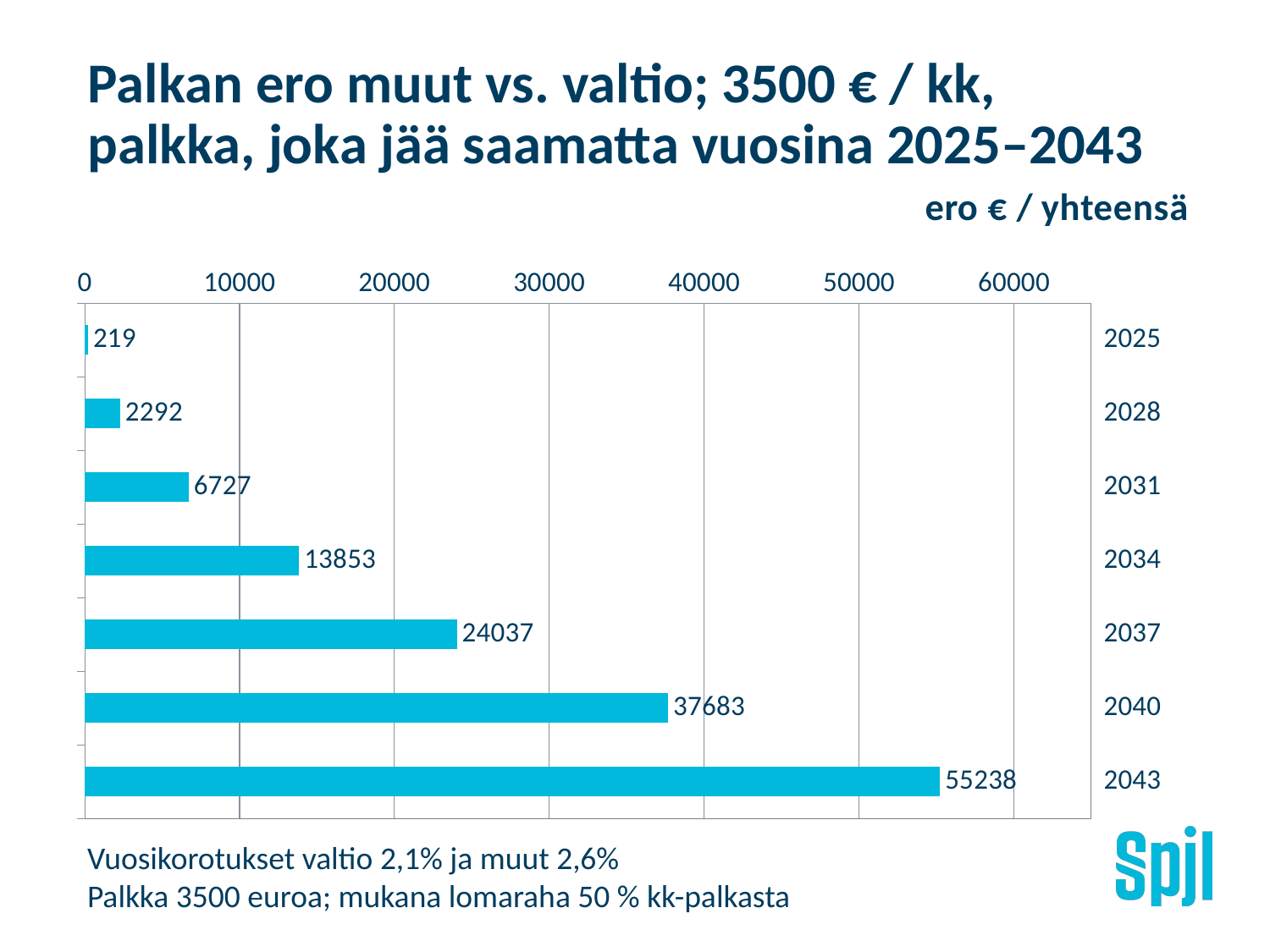
Do the values rise or fall from 2025 to 2043? rise Is the value for 2040 greater or less than 30000? greater Which year has the lowest value? 2025 Which is larger, the value for 2031 or the value for 2028? 2031 Which year has the highest value? 2043 What is the difference between the values for 2037 and 2034? 10184 How many years are shown on the chart? 7 What is the value for 2043? 55238 What is the difference between the values for 2043 and 2040? 17555 What is the value for 2034? 13853 What is the value for 2025? 219 What kind of chart is shown on the slide? bar chart